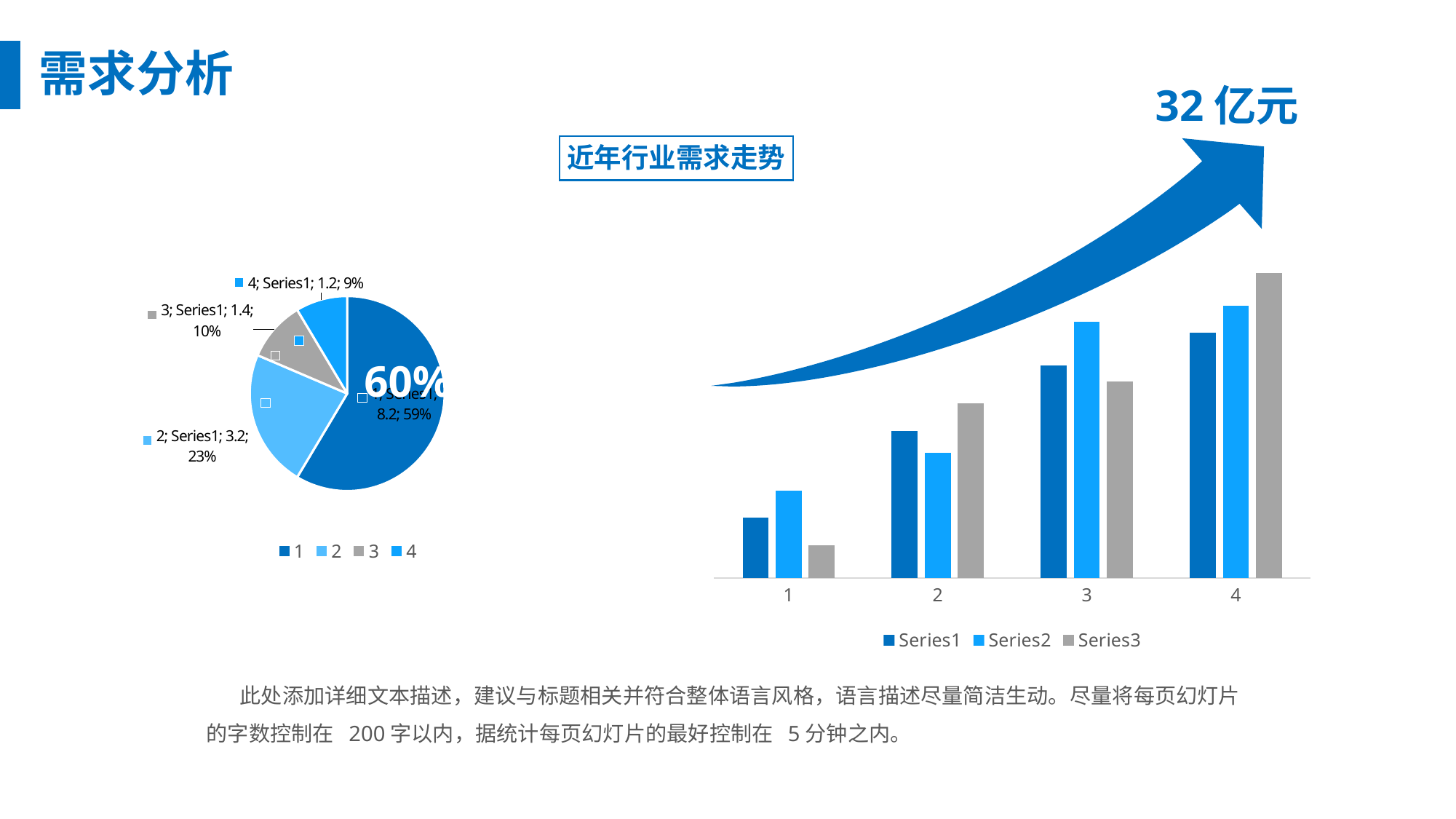
On the bar chart on the right, which category has the lowest Series3 value? 1 On the bar chart on the right, do the Series1 values rise or fall from category 1 to category 4? Rise On the pie chart on the left, which slice is the largest? 1 On the pie chart on the left, how many slices are there? 4 On the pie chart on the left, what value is shown for slice 3? 1.4 On the pie chart on the left, what is the difference between the values of slice 2 and slice 3? 1.8 What type of chart is the chart on the right under the title 近年行业需求走势? Bar chart On the pie chart on the left, what percentage share does slice 4 have? 9% On the pie chart on the left, what value is shown for slice 2? 3.2 On the pie chart on the left, what percentage share does slice 3 have? 10% On the bar chart on the right, how many series does the legend list? 3 On the bar chart on the right, in category 1, which is larger: Series2 or Series3? Series2